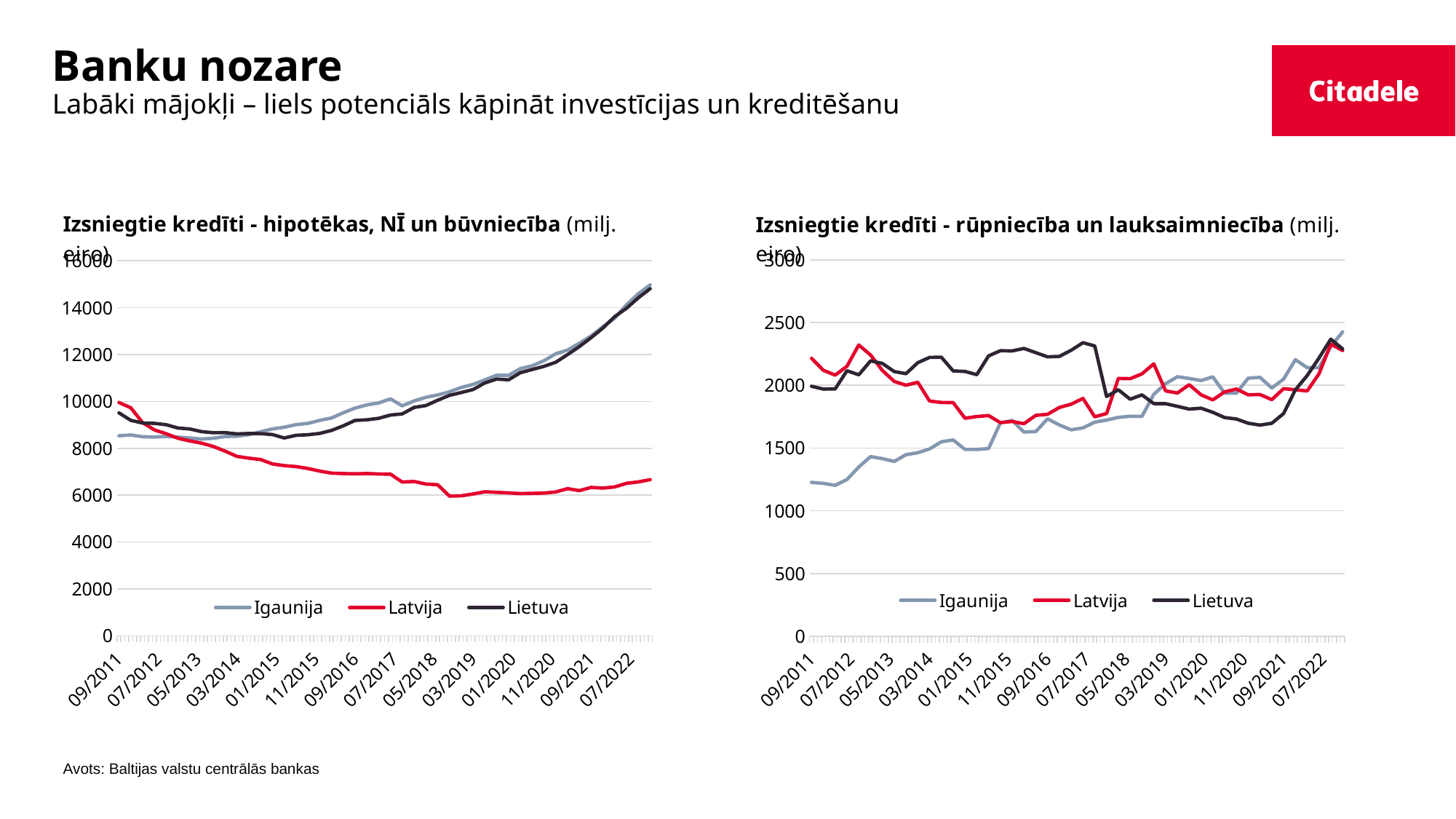
What kind of chart is the left chart, 'Izsniegtie kredīti - hipotēkas, NĪ un būvniecība'? line chart How many series does the legend of the left chart, 'Izsniegtie kredīti - hipotēkas, NĪ un būvniecība', list? 3 In the right chart, 'Izsniegtie kredīti - rūpniecība un lauksaimniecība', is the value for Igaunija at 09/2011 greater or less than 1500? less In the left chart, 'Izsniegtie kredīti - hipotēkas, NĪ un būvniecība', is the value for Latvija at 07/2022 greater or less than 8000? less In the left chart, 'Izsniegtie kredīti - hipotēkas, NĪ un būvniecība', does the Igaunija line rise or fall overall from 09/2011 to 07/2022? rise In the left chart, 'Izsniegtie kredīti - hipotēkas, NĪ un būvniecība', which series has the higher value at 07/2022, Igaunija or Latvija? Igaunija Which series are listed in the legend of the right chart, 'Izsniegtie kredīti - rūpniecība un lauksaimniecība'? Igaunija, Latvija, Lietuva In the left chart, 'Izsniegtie kredīti - hipotēkas, NĪ un būvniecība', is the value for Igaunija at 07/2022 greater or less than 14000? greater In the right chart, 'Izsniegtie kredīti - rūpniecība un lauksaimniecība', does the Igaunija line rise or fall overall from 09/2011 to 07/2022? rise In the right chart, 'Izsniegtie kredīti - rūpniecība un lauksaimniecība', which series has the higher value at 09/2011, Latvija or Igaunija? Latvija In the left chart, 'Izsniegtie kredīti - hipotēkas, NĪ un būvniecība', does the Latvija line rise or fall overall from 09/2011 to 07/2022? fall What kind of chart is the right chart, 'Izsniegtie kredīti - rūpniecība un lauksaimniecība'? line chart